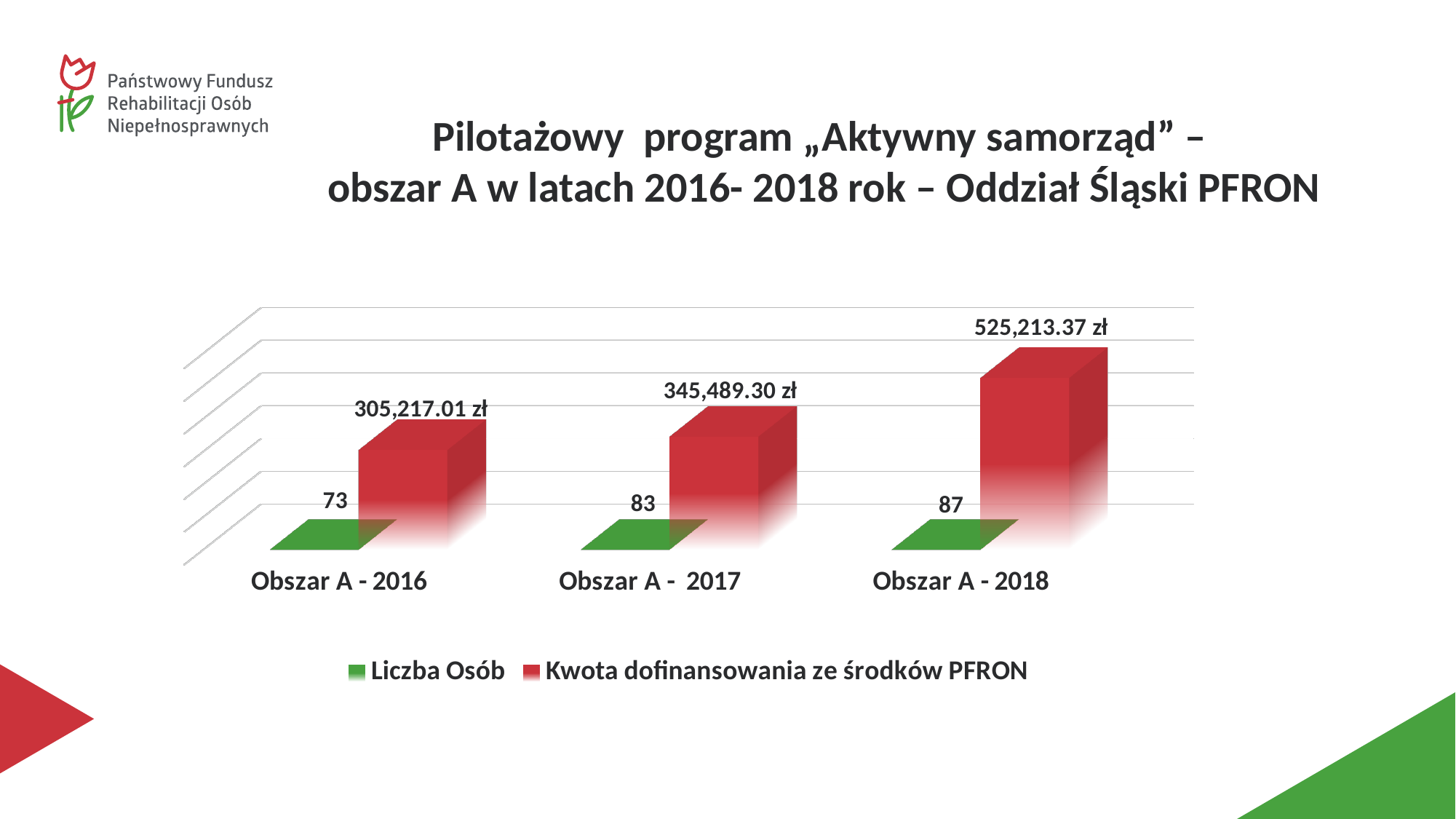
What is the value of Liczba Osób for Obszar A - 2018? 87 What is the Kwota dofinansowania ze środków PFRON for Obszar A - 2018? 525,213.37 zł How many categories are shown on the x axis of the chart? 3 What is the value of Liczba Osób for Obszar A - 2016? 73 Which category has the highest Kwota dofinansowania ze środków PFRON? Obszar A - 2018 Does the Kwota dofinansowania ze środków PFRON rise or fall from Obszar A - 2016 to Obszar A - 2018? rise Which is larger, the Kwota dofinansowania ze środków PFRON for Obszar A - 2016 or for Obszar A - 2017? Obszar A - 2017 What is the difference in Liczba Osób between Obszar A - 2018 and Obszar A - 2016? 14 What is the Kwota dofinansowania ze środków PFRON for Obszar A - 2017? 345,489.30 zł Which category has the lowest Liczba Osób? Obszar A - 2016 How many series does the legend list? 2 What is the difference in Kwota dofinansowania ze środków PFRON between Obszar A - 2018 and Obszar A - 2017? 179,724.07 zł